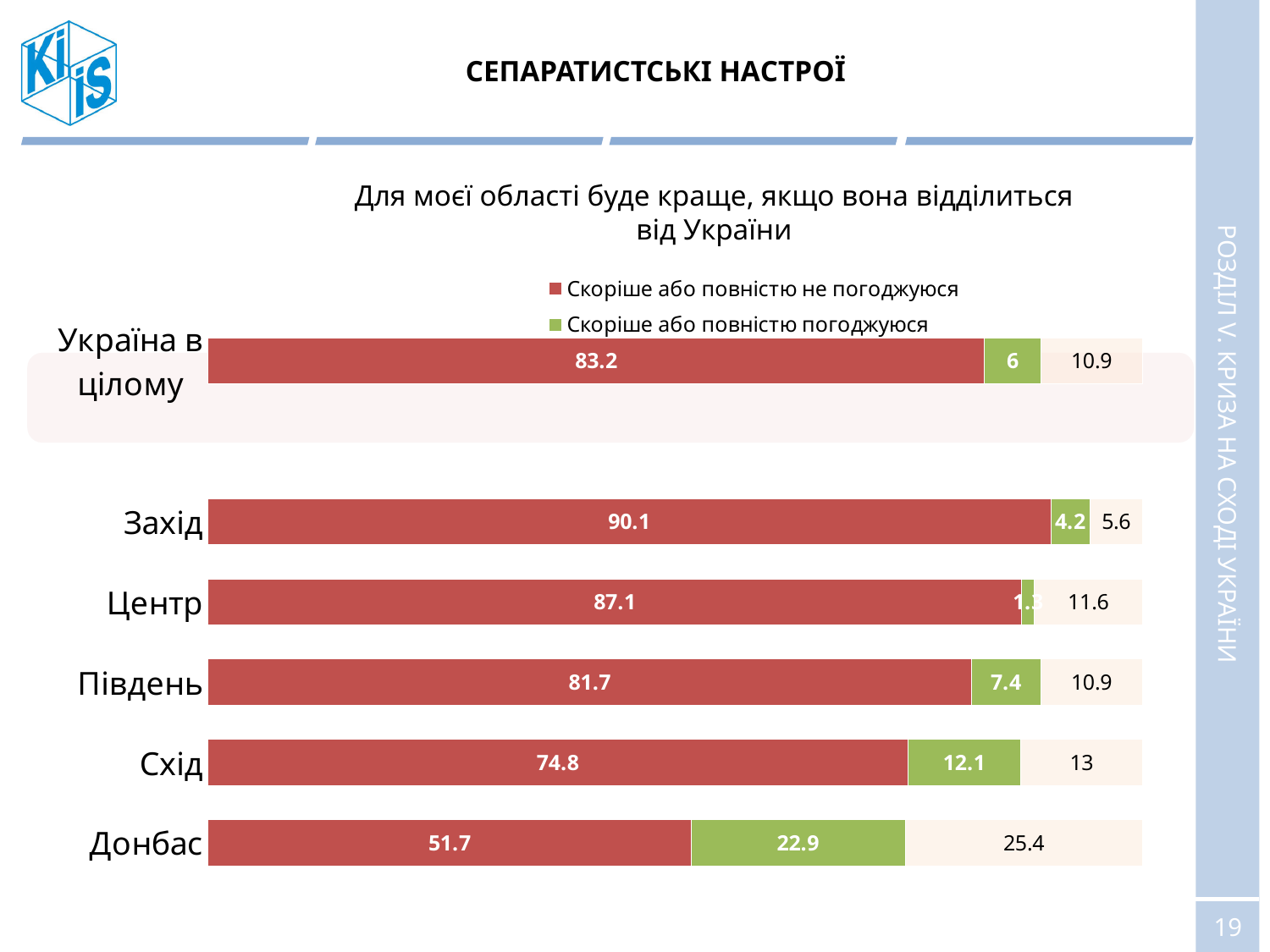
Which is larger: the "Скоріше або повністю погоджуюся" value for Південь or for Схід? Схід What is the difference between the "Скоріше або повністю не погоджуюся" values for Захід and Донбас? 38.4 Which region has the highest value for "Скоріше або повністю погоджуюся"? Донбас Which region has the lowest value for "Скоріше або повністю не погоджуюся"? Донбас What type of chart is shown on the slide? bar chart What is the value for "Скоріше або повністю погоджуюся" for Схід? 12.1 How many series does the legend list? 2 Which region has the highest value for "Скоріше або повністю не погоджуюся"? Захід What is the value for "Скоріше або повністю не погоджуюся" for Донбас? 51.7 What is the value for "Скоріше або повністю не погоджуюся" for Захід? 90.1 How many categories (regions) are shown on the chart? 6 What is the value for "Скоріше або повністю погоджуюся" for Україна в цілому? 6